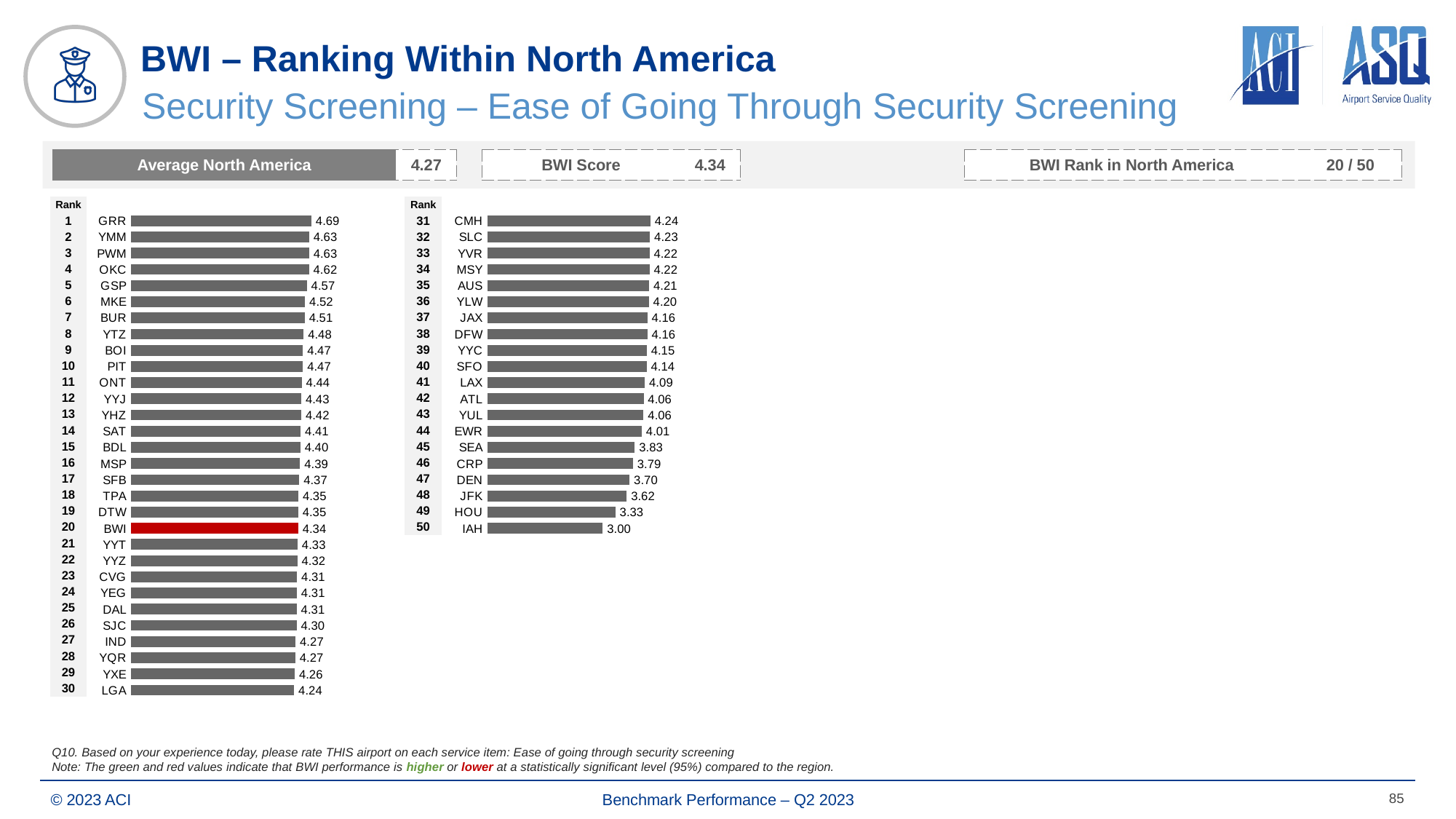
What is the difference between the BWI score and the Average North America score? 0.07 What is the score for IAH? 3.00 Which has a higher score, LAX or HOU? LAX What is the difference between the scores of GRR and IAH? 1.69 Which airport has the highest score in the chart? GRR How many airports are ranked in the chart? 50 Which airport has the lowest score in the chart? IAH What is the score for BWI in the ranking chart? 4.34 Which airport's bar is highlighted in red in the chart? BWI What kind of chart is used to show the airport scores? Bar chart What is the score for DEN? 3.70 Do the scores rise or fall as the rank number increases down the list? Fall